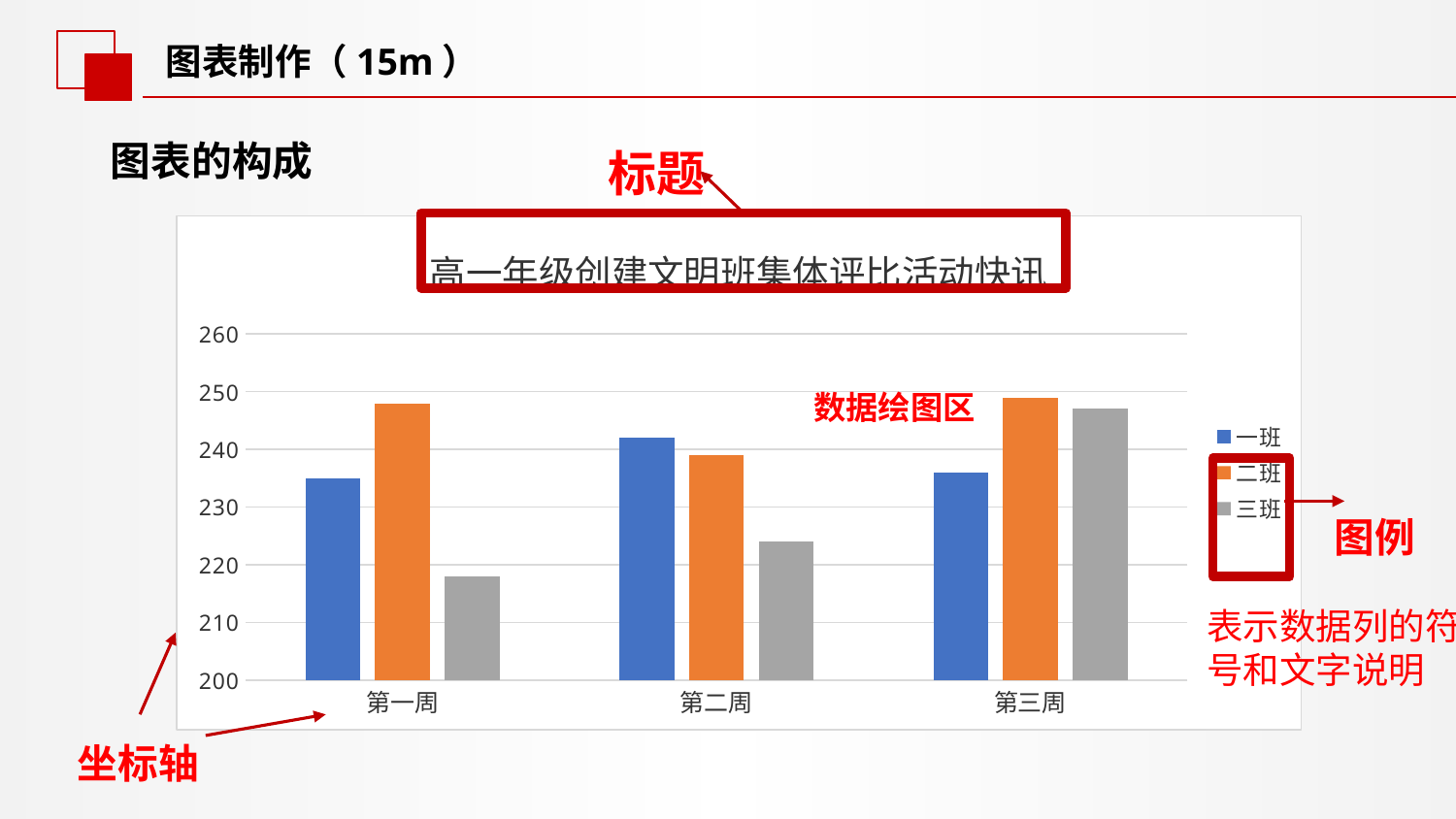
Is the value for 三班 in 第二周 greater or less than 230? less What is the title of the chart? 高一年级创建文明班集体评比活动快讯 How many categories are shown on the x axis? 3 Is the value for 二班 in 第一周 greater or less than 240? greater Which series has the lowest value in 第二周? 三班 Which is larger: 二班 in 第二周 or 三班 in 第二周? 二班 What kind of chart is shown on the slide? bar chart Which series has the lowest value in 第一周? 三班 How many series does the legend list? 3 Do the values for 三班 rise or fall from 第一周 to 第三周? rise Which series has the highest value in 第一周? 二班 Which series has the lowest value in 第三周? 一班